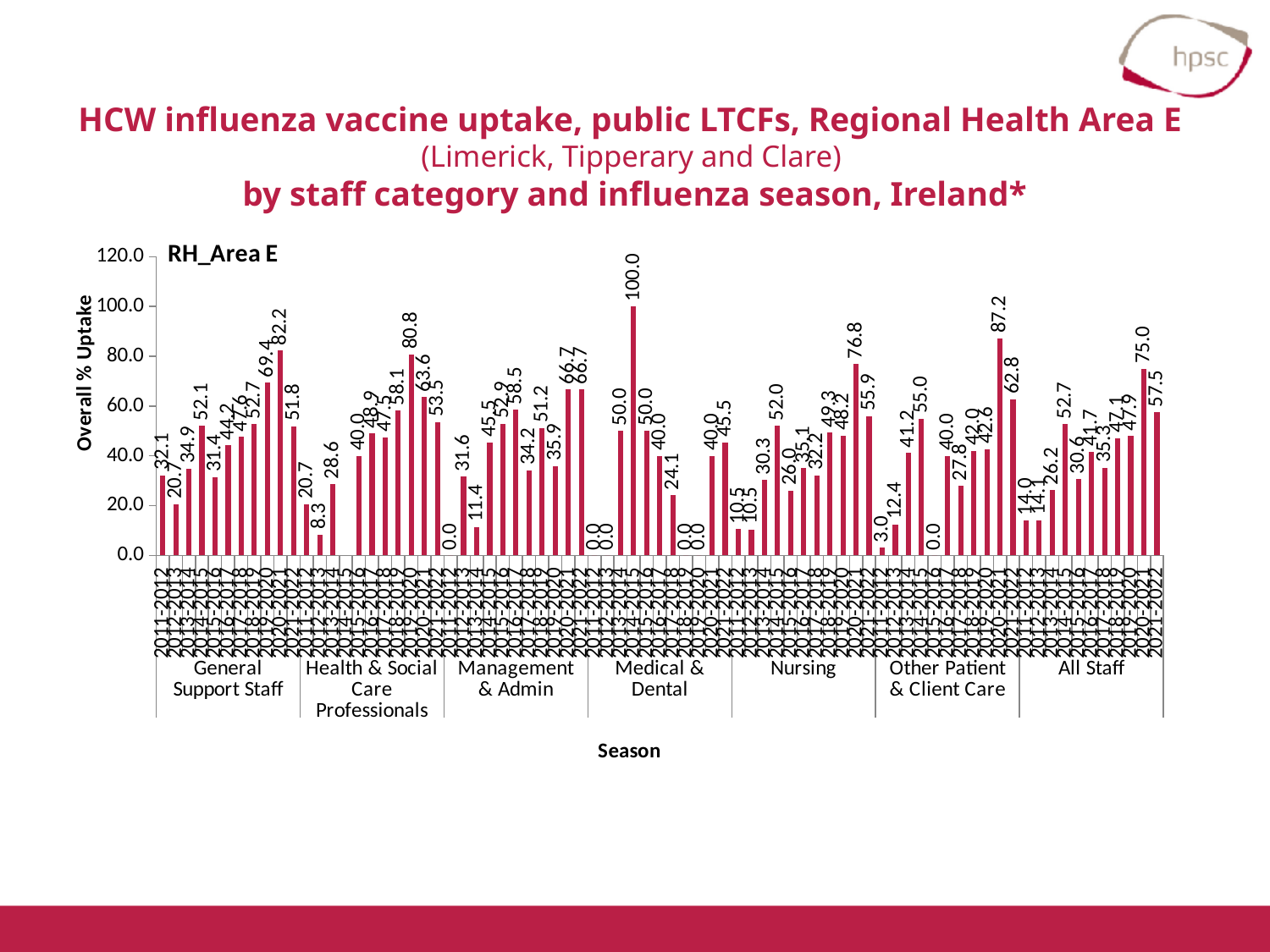
What is the difference between the highest value in the Other Patient & Client Care group (87.2) and the highest value in the All Staff group (75.0)? 12.2 What is the highest value shown in the Health & Social Care Professionals group? 80.8 What is the highest value shown in the Nursing group? 76.8 How many staff categories are shown along the x axis of the chart? 7 What is the value of the tallest bar on the chart? 100.0 Which is larger: the highest value in the Nursing group or the highest value in the All Staff group? Nursing (76.8) What is the highest value shown in the General Support Staff group? 82.2 What is the label on the vertical axis of the chart? Overall % Uptake What kind of chart is shown on the slide? bar chart